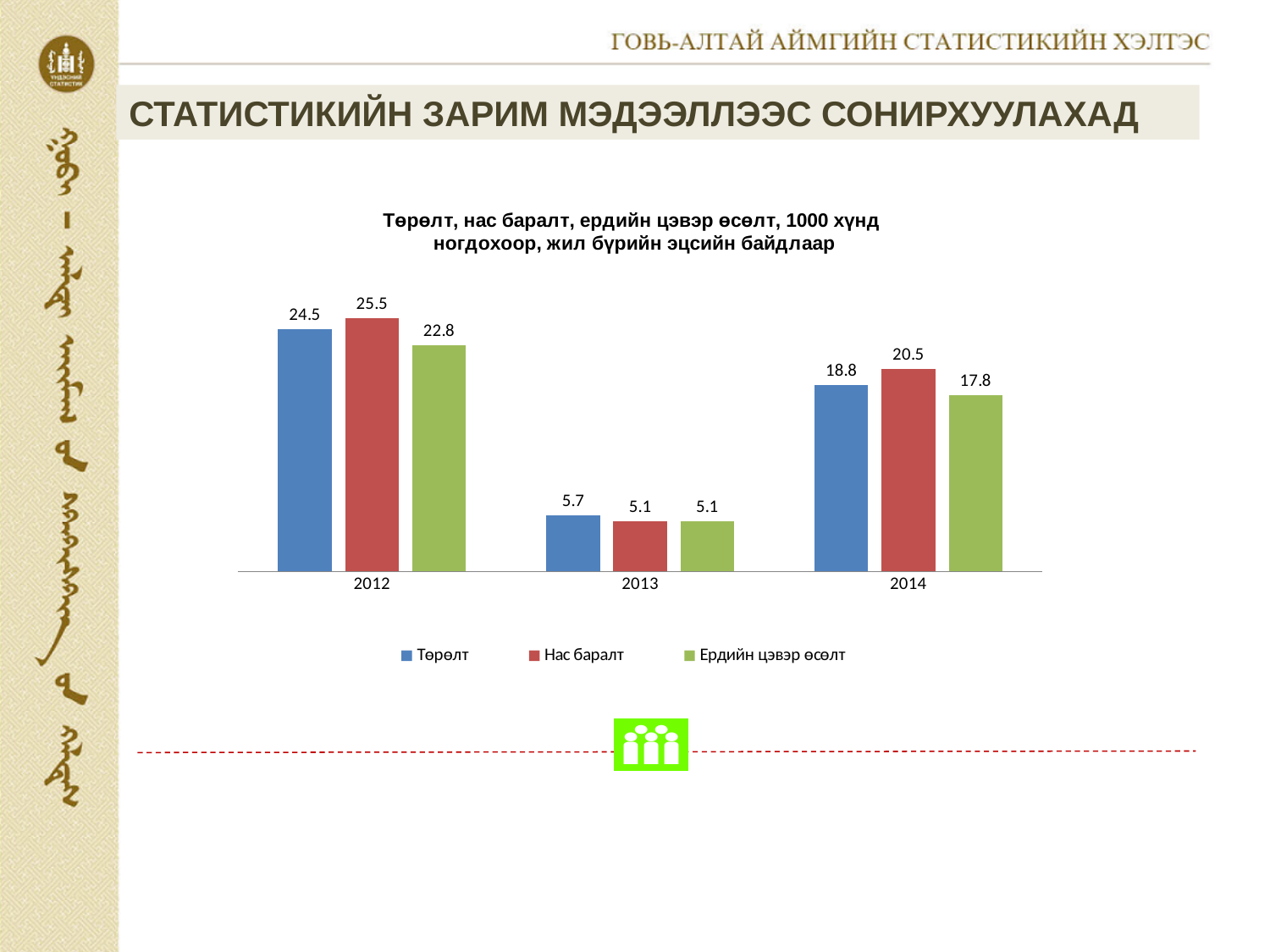
What is the difference between the Төрөлт values for 2012 and 2014? 5.7 Which year has the lowest value for Төрөлт? 2013 Which colour represents Төрөлт in the legend? Blue What kind of chart is shown on the slide? Bar chart What is the value for Төрөлт in 2012? 24.5 How many years are shown on the x axis? 3 What is the value for Ердийн цэвэр өсөлт in 2013? 5.1 How many series does the legend list? 3 Which is larger in 2014: Төрөлт or Нас баралт? Нас баралт Does the value for Ердийн цэвэр өсөлт rise or fall from 2012 to 2013? Fall What is the value for Нас баралт in 2014? 20.5 Which year has the highest value for Нас баралт? 2012